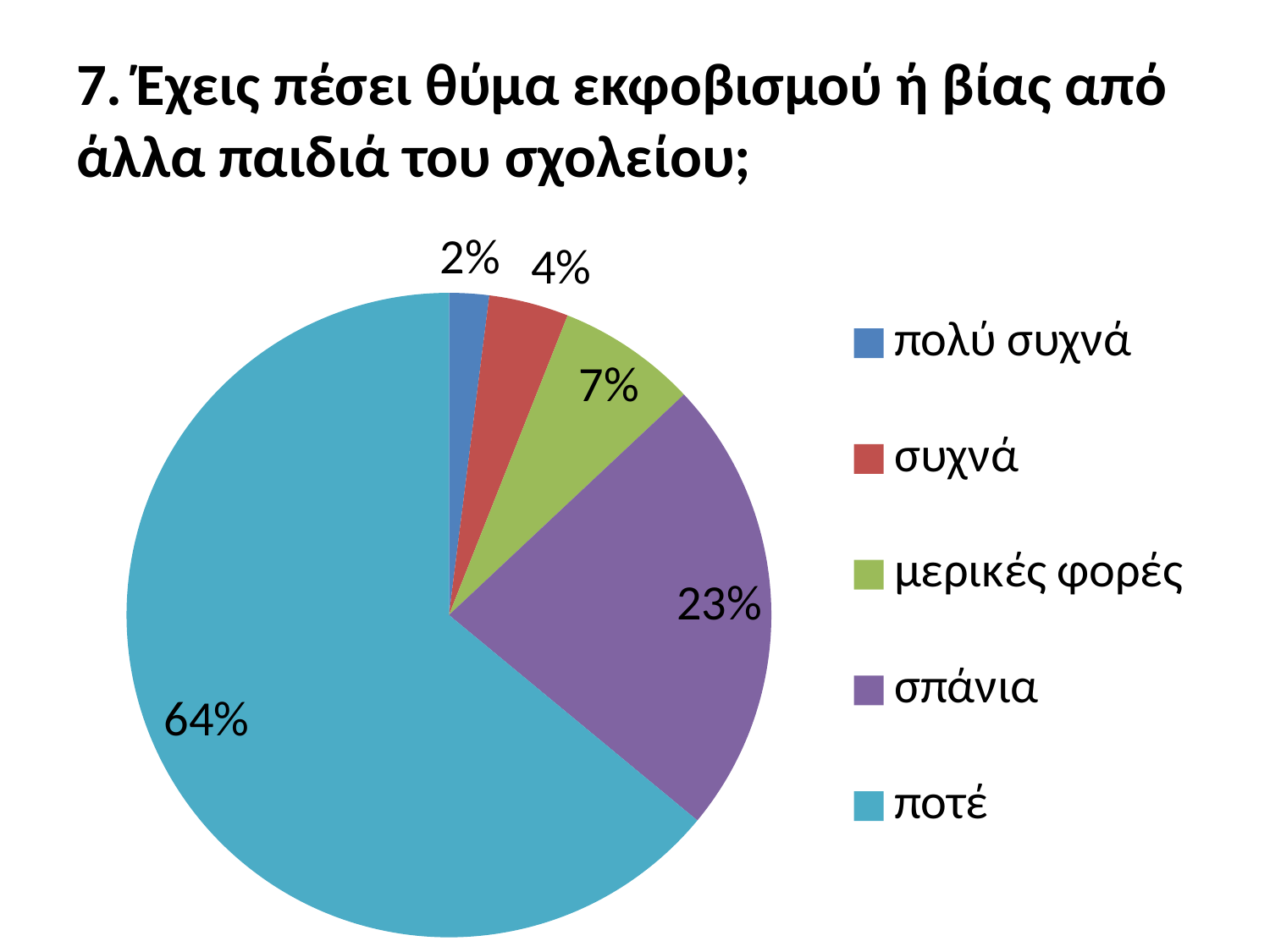
What is the value for "πολύ συχνά"? 2% What is the value for "μερικές φορές"? 7% What kind of chart is shown on the slide? pie chart Which category has the largest slice of the pie? ποτέ What colour is the slice for "σπάνια"? purple Which category has the smallest slice of the pie? πολύ συχνά What share of the pie does "ποτέ" have? 64% What share of the pie does "σπάνια" have? 23% Which is larger, the share for "συχνά" or the share for "μερικές φορές"? μερικές φορές What is the difference between the shares of "ποτέ" and "σπάνια"? 41% What is the value for "συχνά"? 4% How many categories does the legend list? 5